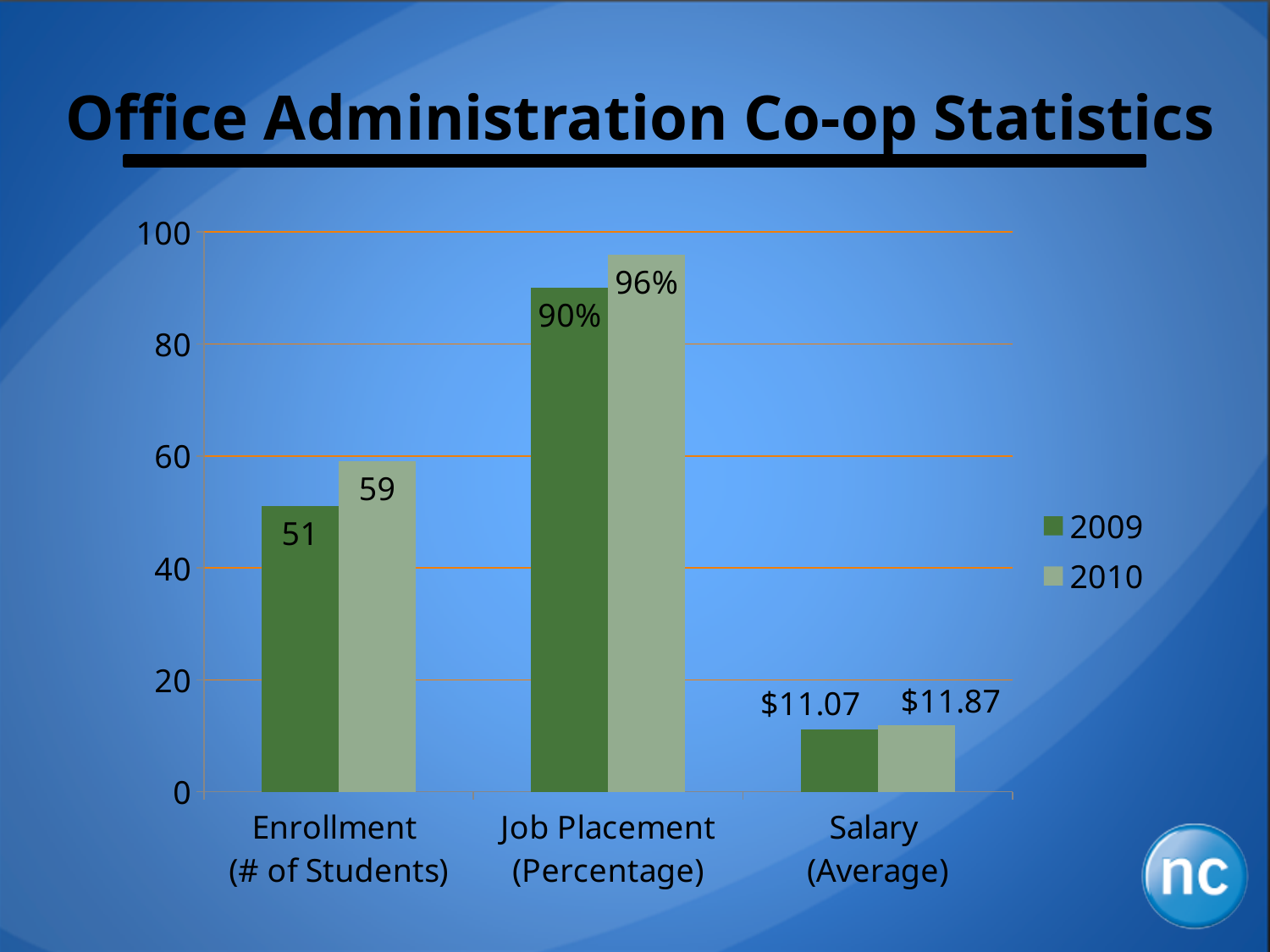
What was the enrollment (# of students) in 2010? 59 What was the job placement percentage in 2010? 96% What is the difference in job placement percentage between 2010 and 2009? 6% Is the 2009 enrollment value greater or less than 60? less Which year had the higher job placement percentage, 2009 or 2010? 2010 What was the average salary in 2010? $11.87 What was the enrollment (# of students) in 2009? 51 What type of chart is shown on the slide? Bar chart How many categories are shown on the x axis? 3 By how many students did enrollment increase from 2009 to 2010? 8 What was the average salary in 2009? $11.07 How many series does the legend list? 2